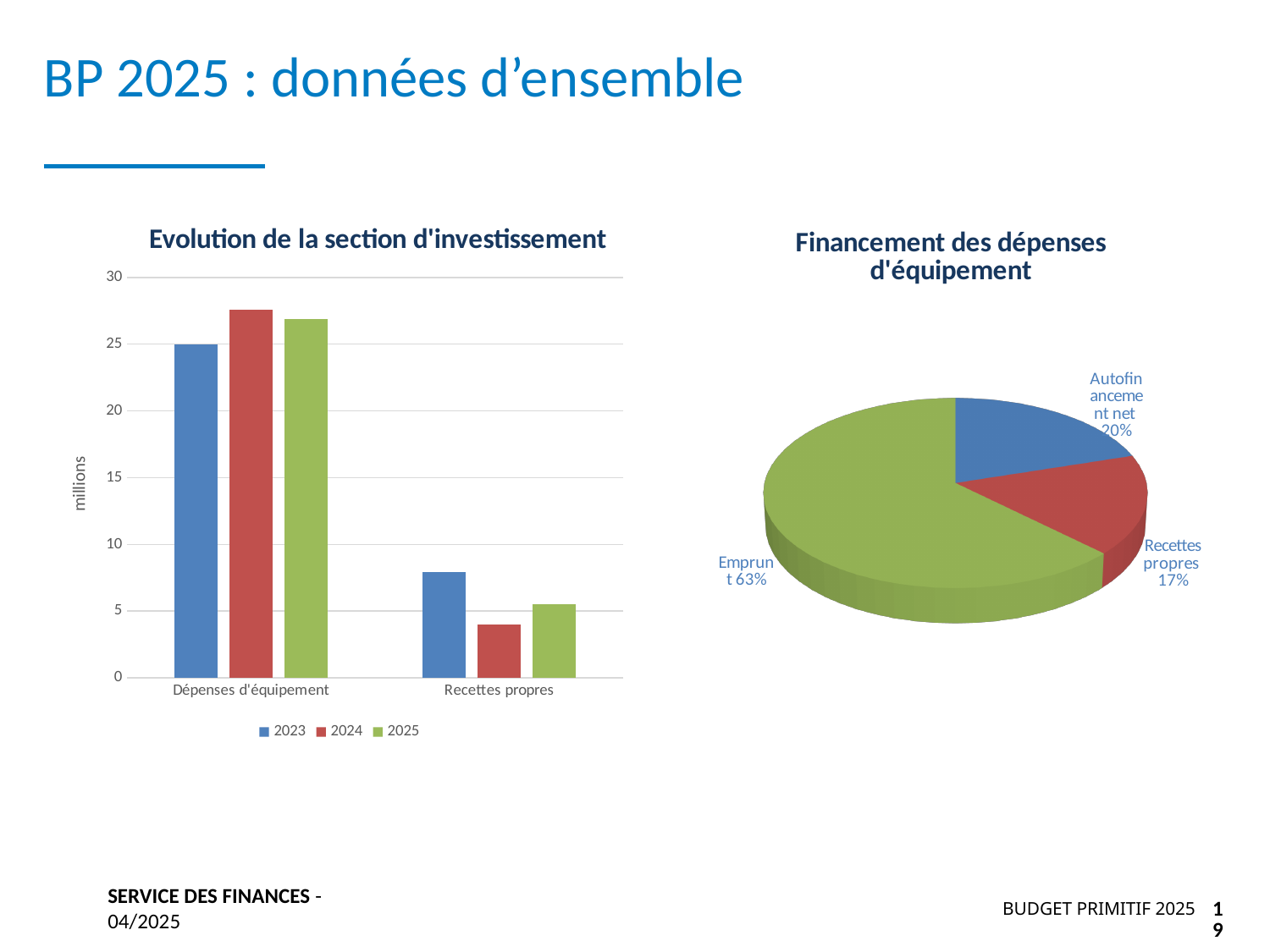
In the chart 'Evolution de la section d'investissement', how many series does the legend list? 3 In the chart 'Evolution de la section d'investissement', what is the label on the vertical axis? millions What kind of chart is 'Evolution de la section d'investissement'? bar chart In the chart 'Evolution de la section d'investissement', which year has the lowest value for Recettes propres? 2024 In the chart 'Evolution de la section d'investissement', which year has the highest value for Recettes propres? 2023 In the chart 'Evolution de la section d'investissement', is the 2024 value for Recettes propres greater or less than 5? less In the chart 'Evolution de la section d'investissement', is the 2024 value for Dépenses d'équipement greater or less than 25? greater In the chart 'Evolution de la section d'investissement', is the 2023 value for Recettes propres greater or less than 5? greater In the chart 'Evolution de la section d'investissement', how many categories are shown on the x axis? 2 In the pie chart 'Financement des dépenses d'équipement', what is the value shown for Autofinancement net? 20% In the pie chart 'Financement des dépenses d'équipement', what is the difference between the Emprunt share and the Recettes propres share? 46% In the pie chart 'Financement des dépenses d'équipement', what share does Emprunt represent? 63%